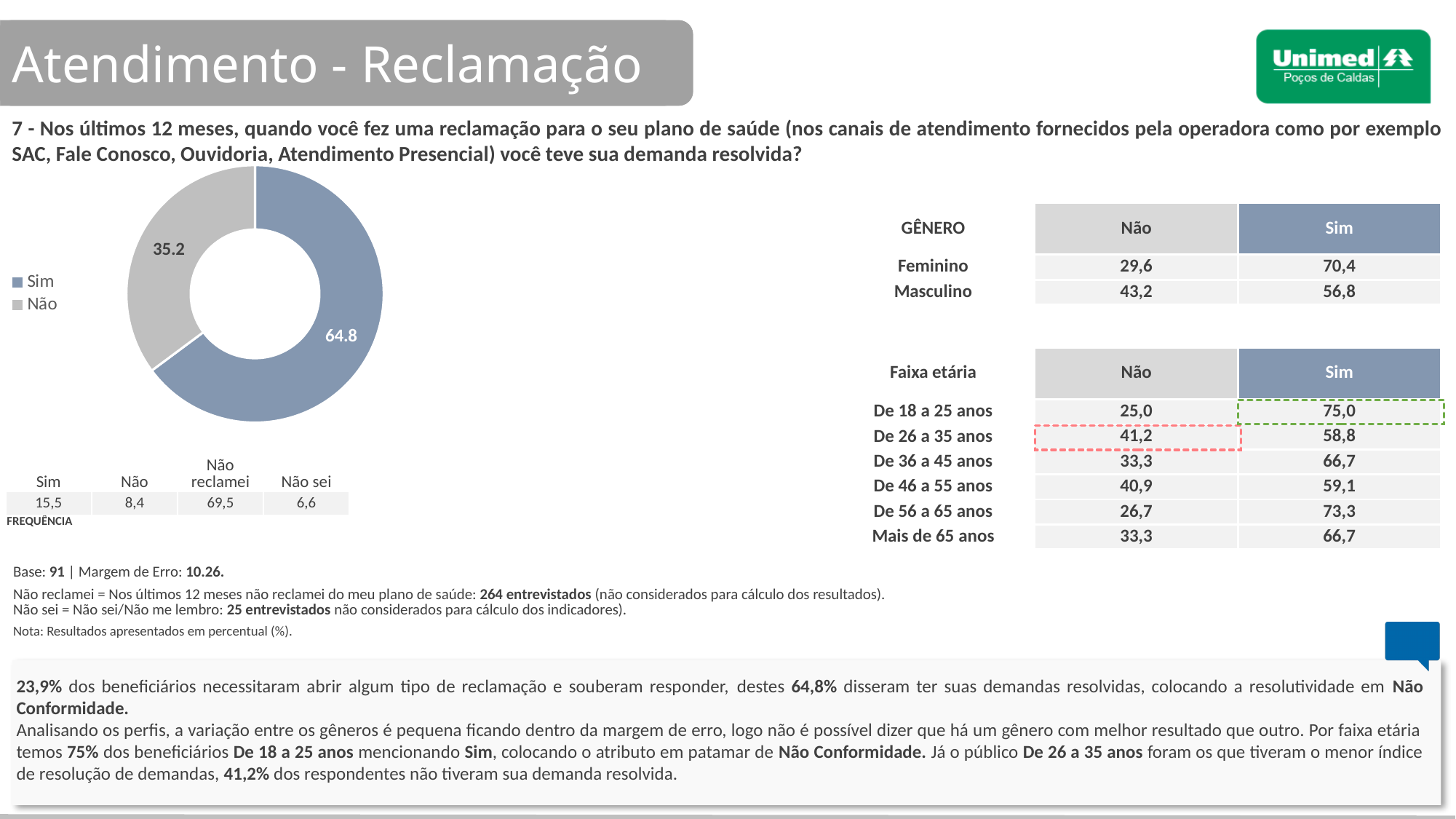
What colour is the "Não" slice in the donut chart? Light grey What value is shown for the "Sim" slice of the donut chart? 64.8 What is the difference between the "Sim" and "Não" values in the donut chart? 29.6 What kind of chart is shown on the slide? Donut (pie) chart What value is shown for the "Não" slice of the donut chart? 35.2 What share of the donut chart does the "Não" slice represent? 35.2% How many slices does the donut chart have? 2 Which slice of the donut chart is the largest? Sim In the donut chart, is the value for "Sim" larger or smaller than the value for "Não"? larger What colour is the "Sim" slice in the donut chart? Blue-grey How many entries does the legend of the donut chart list? 2 Which slice of the donut chart is the smallest? Não